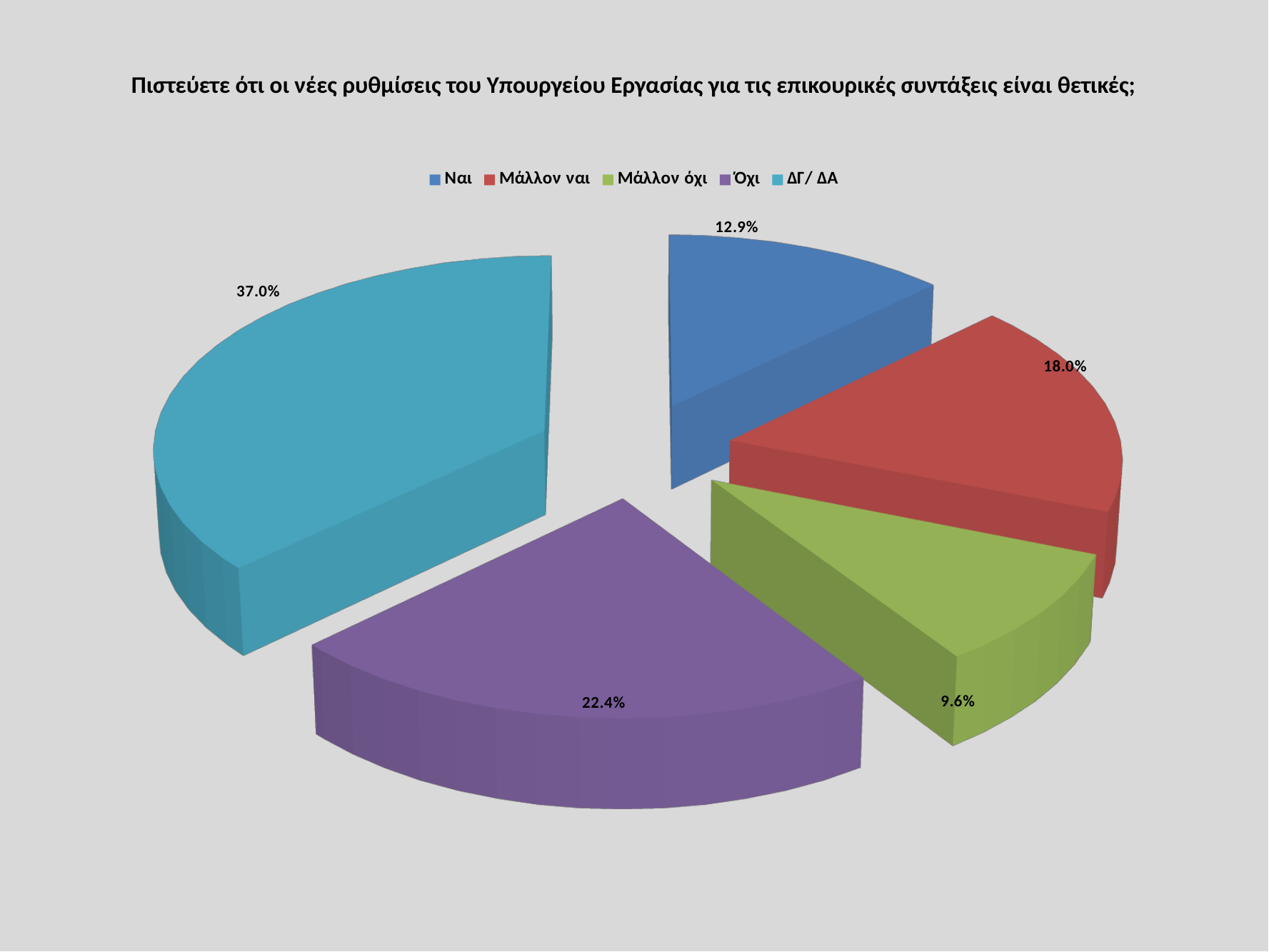
Which category has the largest share of the pie? ΔΓ/ ΔΑ What is the value for ΔΓ/ ΔΑ? 37.0% What is the value for Όχι? 22.4% Which category has the smallest share of the pie? Μάλλον όχι What is the difference between the values for Όχι and Ναι? 9.5% Which is larger, the value for Μάλλον ναι or the value for Όχι? Όχι What colour is the slice for ΔΓ/ ΔΑ? cyan How many categories does the pie chart have? 5 What is the value for Μάλλον ναι? 18.0% What kind of chart is shown on the slide? pie chart What is the value for Ναι? 12.9% What is the value for Μάλλον όχι? 9.6%